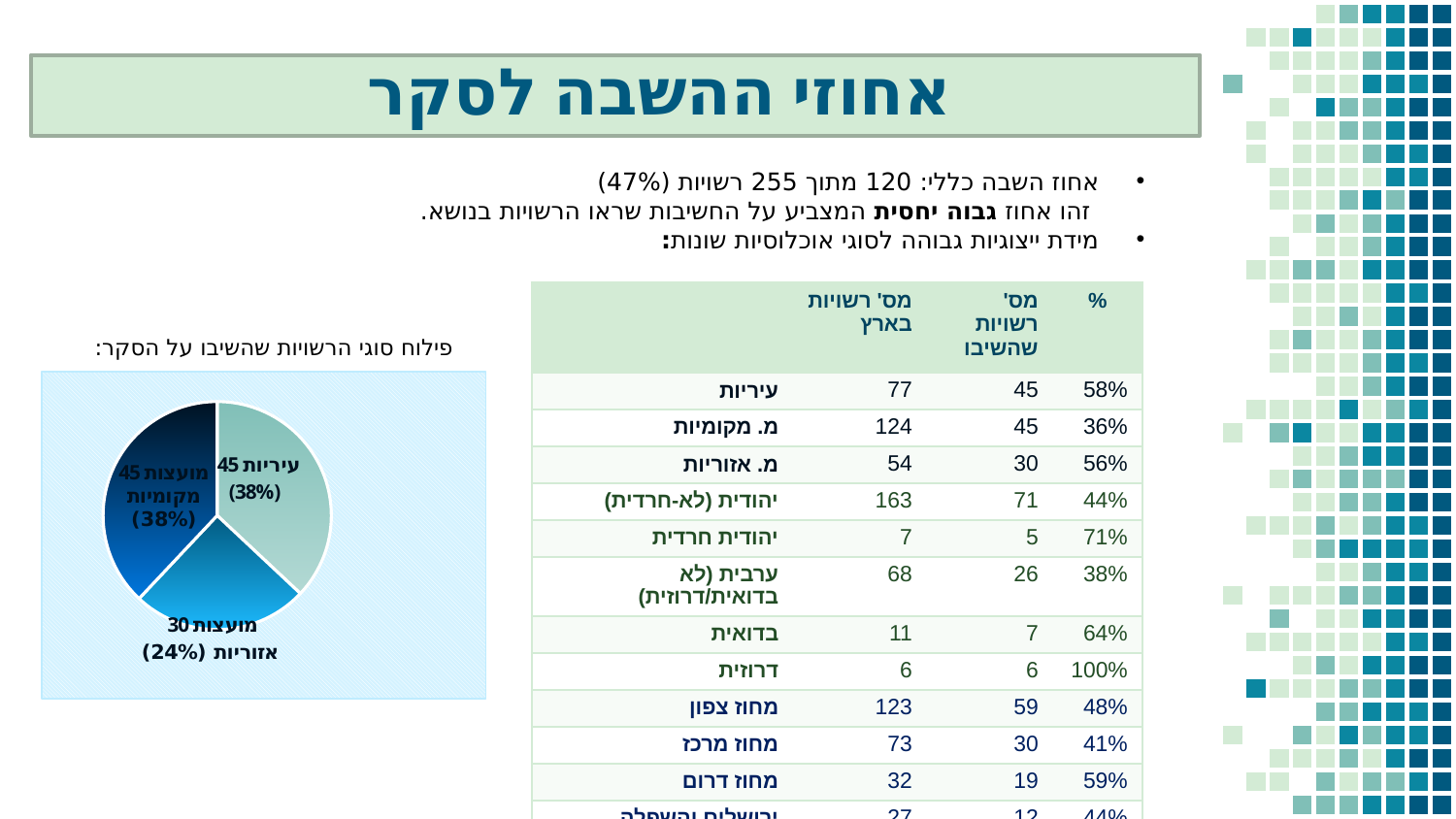
How many slices does the pie chart have? 3 What is the total of all slices in the pie chart? 120 What share of the pie does the מועצות אזוריות slice represent? 24% Which slice of the pie chart is the smallest? מועצות אזוריות What kind of chart is shown on the slide? pie chart What is the difference between the עיריות value and the מועצות אזוריות value in the pie chart? 15 What share of the pie does the עיריות slice represent? 38% What value is shown for the עיריות slice of the pie chart? 45 What is the caption written above the pie chart? פילוח סוגי הרשויות שהשיבו על הסקר: What value is shown for the מועצות אזוריות slice of the pie chart? 30 What value is shown for the מועצות מקומיות slice of the pie chart? 45 Which is larger in the pie chart, מועצות מקומיות or מועצות אזוריות? מועצות מקומיות